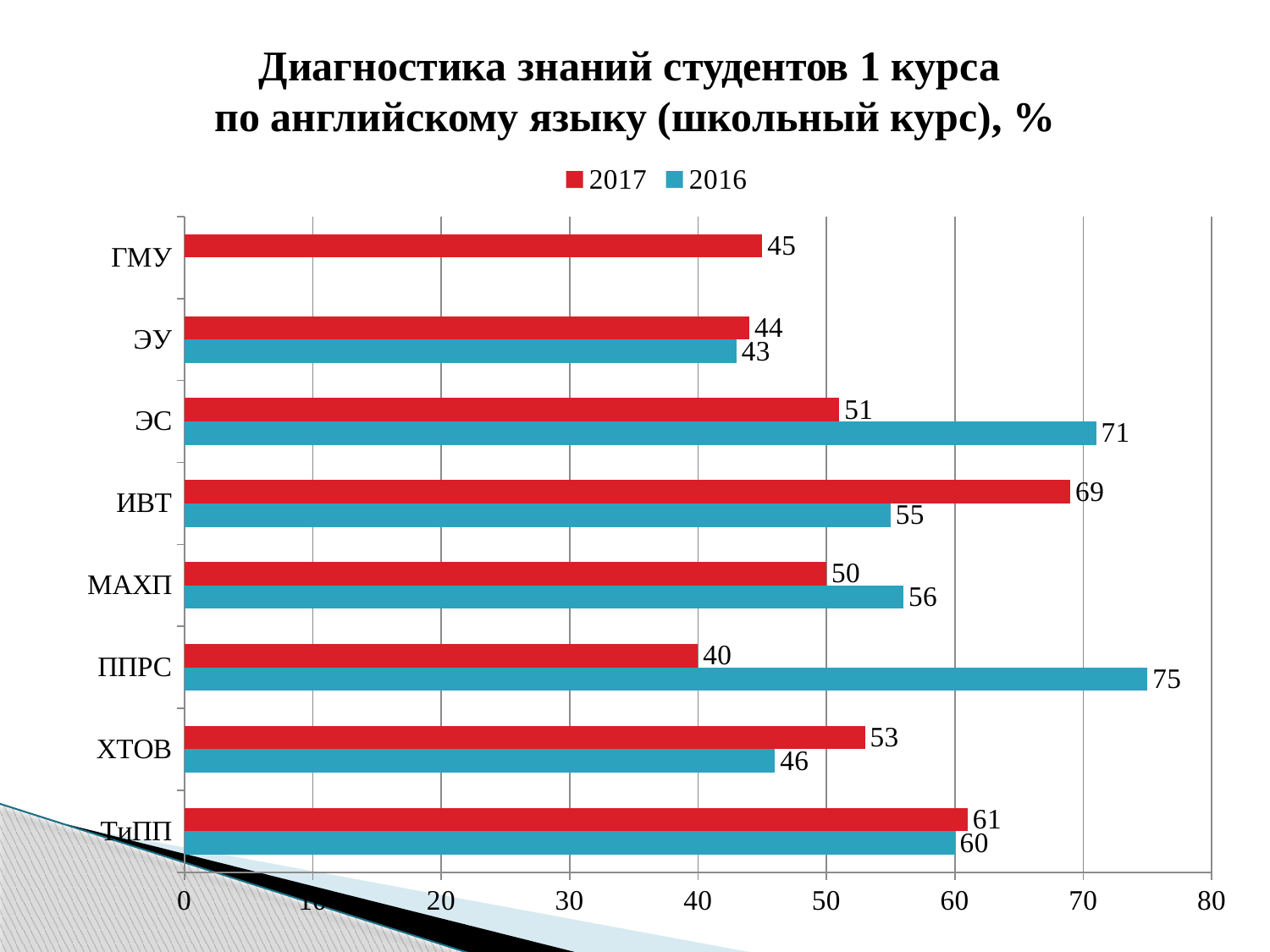
What is the difference between the 2016 and 2017 values for ЭС? 20 How many series does the legend list? 2 Which colour represents the 2016 series? Blue What kind of chart is shown on the slide? Bar chart What is the 2017 value for ГМУ? 45 What is the 2016 value for ППРС? 75 What is the 2017 value for ИВТ? 69 Which category has the highest 2017 value? ИВТ Which category has the lowest 2017 value? ППРС Which is larger for МАХП, the 2017 value or the 2016 value? 2016 How many categories are shown on the chart? 8 Which category has the highest 2016 value? ППРС